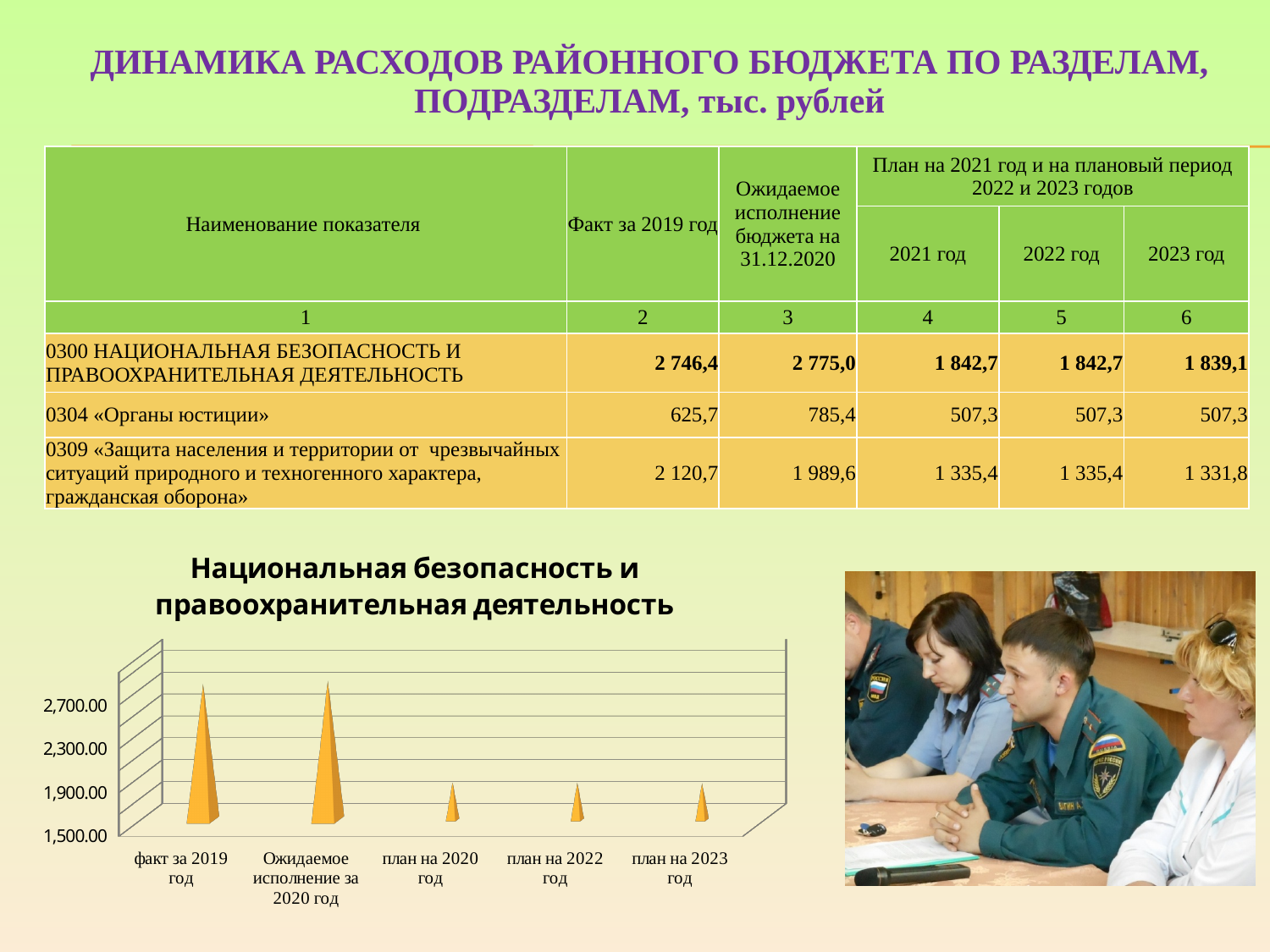
On the chart, which is larger: the value for "факт за 2019 год" or the value for "план на 2020 год"? факт за 2019 год On the chart, is the value for "план на 2022 год" greater or less than 2,300.00? less On the chart, is the value for "Ожидаемое исполнение за 2020 год" greater or less than 2,300.00? greater On the chart, which is larger: the value for "план на 2022 год" or the value for "Ожидаемое исполнение за 2020 год"? Ожидаемое исполнение за 2020 год What is the lowest value shown on the vertical axis of the chart? 1,500.00 On the chart, is the value for "факт за 2019 год" greater or less than 2,300.00? greater How many categories are plotted on the chart "Национальная безопасность и правоохранительная деятельность"? 5 What is the title of the chart on the slide? Национальная безопасность и правоохранительная деятельность What kind of chart is shown under the title "Национальная безопасность и правоохранительная деятельность"? bar chart On the chart, are the values for the plan years (2020, 2022, 2023) higher or lower than the value for "факт за 2019 год"? lower